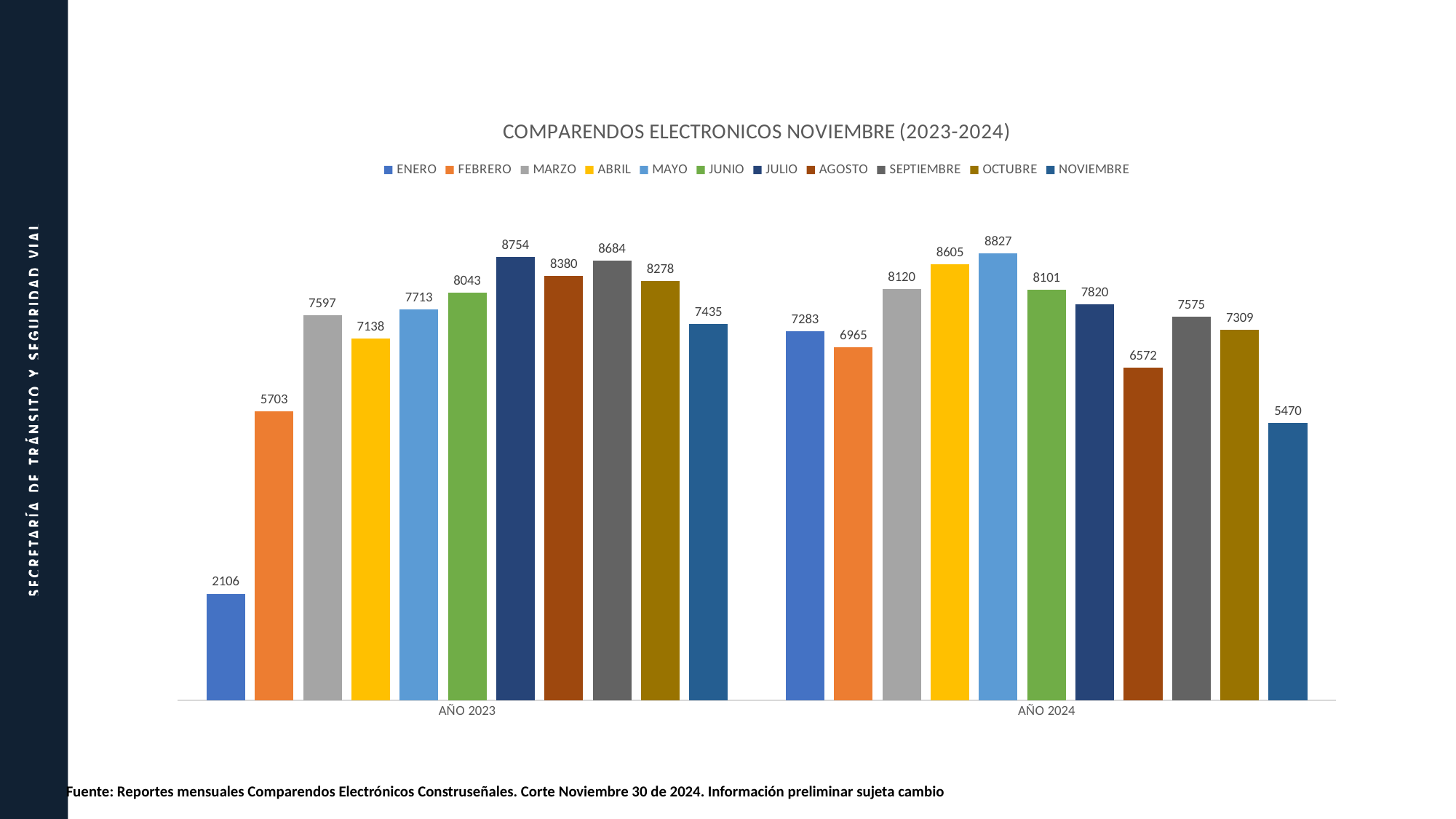
What is the value for SEPTIEMBRE in AÑO 2023? 8684 What kind of chart is shown on the slide? Bar chart What is the value for MAYO in AÑO 2024? 8827 What is the value for NOVIEMBRE in AÑO 2024? 5470 How many series does the legend list? 11 How many categories are shown on the x axis? 2 Which month has the lowest value in AÑO 2024? NOVIEMBRE Which is larger, the AGOSTO value for AÑO 2023 or for AÑO 2024? AÑO 2023 What is the difference between the ENERO values for AÑO 2024 and AÑO 2023? 5177 What is the value for ENERO in AÑO 2023? 2106 Which month has the highest value in AÑO 2023? JULIO What is the title of the chart? COMPARENDOS ELECTRONICOS NOVIEMBRE (2023-2024)